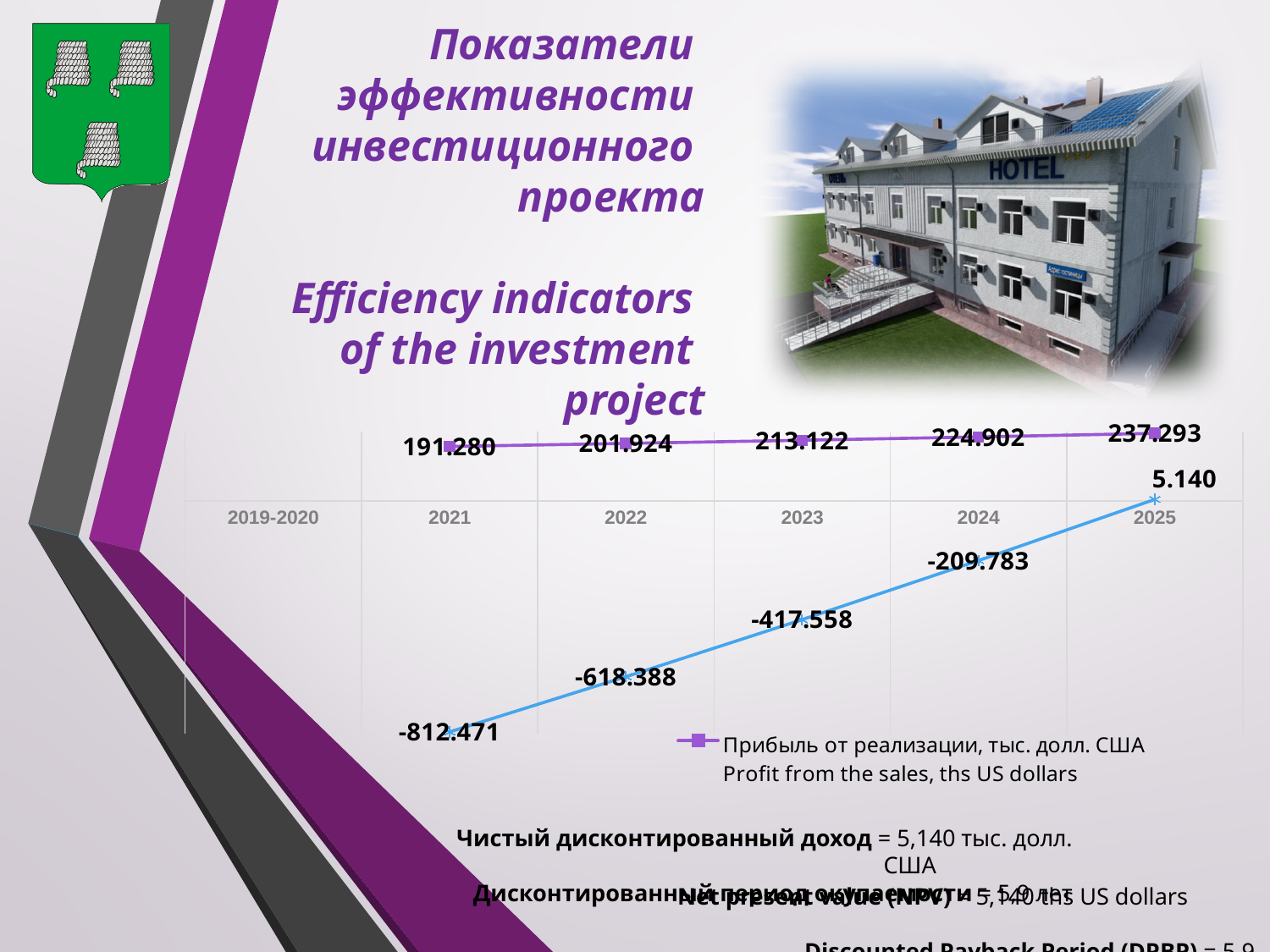
In which year does the purple 'Profit from the sales' line reach its highest value? 2025 What is the value of the blue line in 2022? -618.388 What is the value of the blue line in 2025? 5.140 Which is larger: the purple line's value in 2024 or its value in 2023? 2024 How many category labels are shown on the x axis? 6 What is the difference between the purple line's values in 2025 and 2021? 46.013 Does the blue line rise or fall from 2021 to 2025? rise What type of chart is shown on the slide? line chart Does the purple 'Profit from the sales' line rise or fall from 2021 to 2025? rise What is the value of the purple 'Profit from the sales' line in 2021? 191.280 What is the value of the purple 'Profit from the sales' line in 2025? 237.293 In which year does the blue line reach its lowest value? 2021